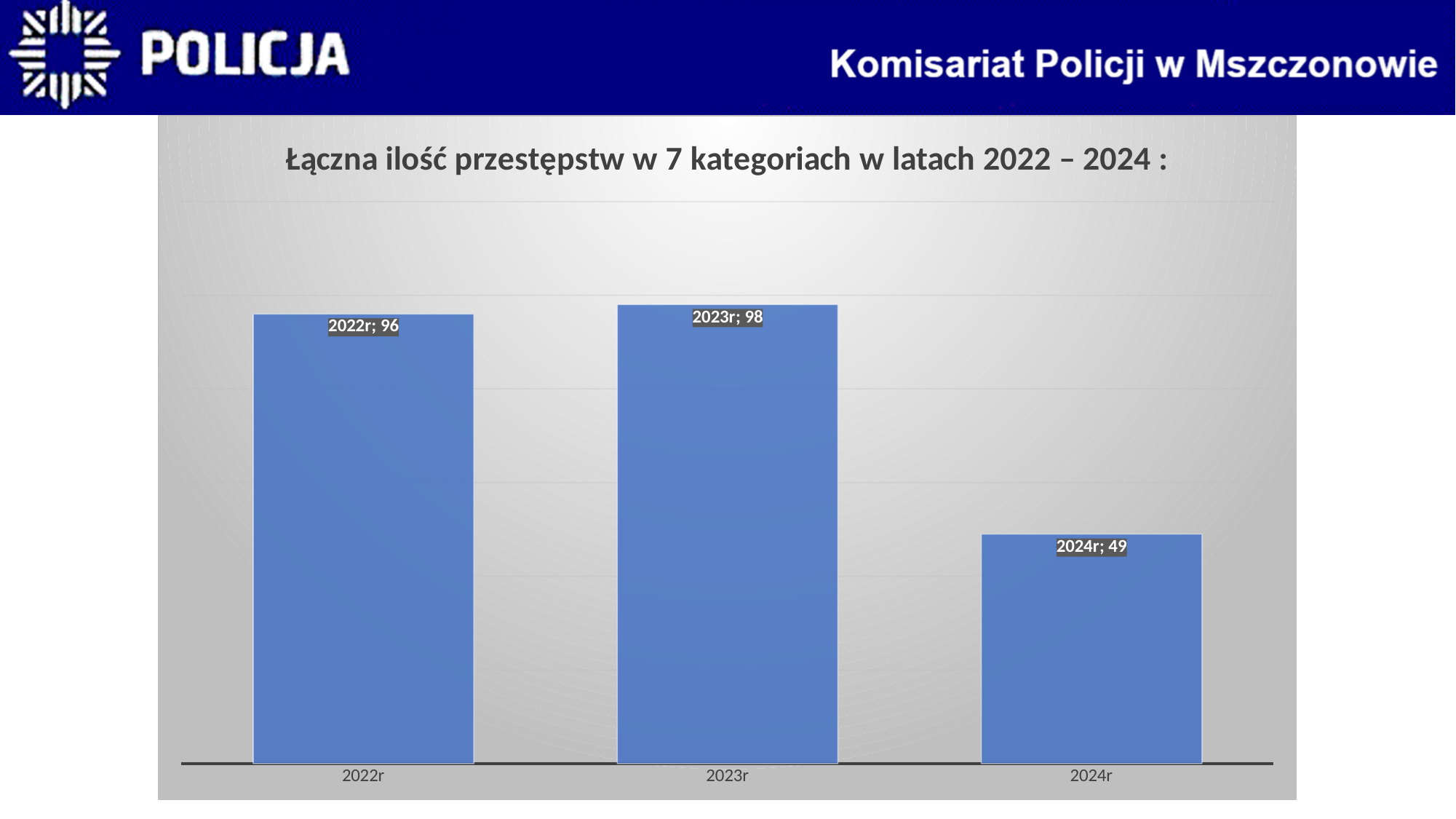
What is the value for 2023r? 98 What is the difference between the values for 2023r and 2024r? 49 What is the value for 2024r? 49 Which year has the highest value? 2023r How many years are shown on the chart? 3 What kind of chart is shown on the slide? bar chart What is the value for 2022r? 96 Does the value rise or fall from 2023r to 2024r? fall What is the title of the chart? Łączna ilość przestępstw w 7 kategoriach w latach 2022 – 2024 : Which is larger, the value for 2022r or the value for 2024r? 2022r Which year has the lowest value? 2024r What is the difference between the values for 2022r and 2024r? 47